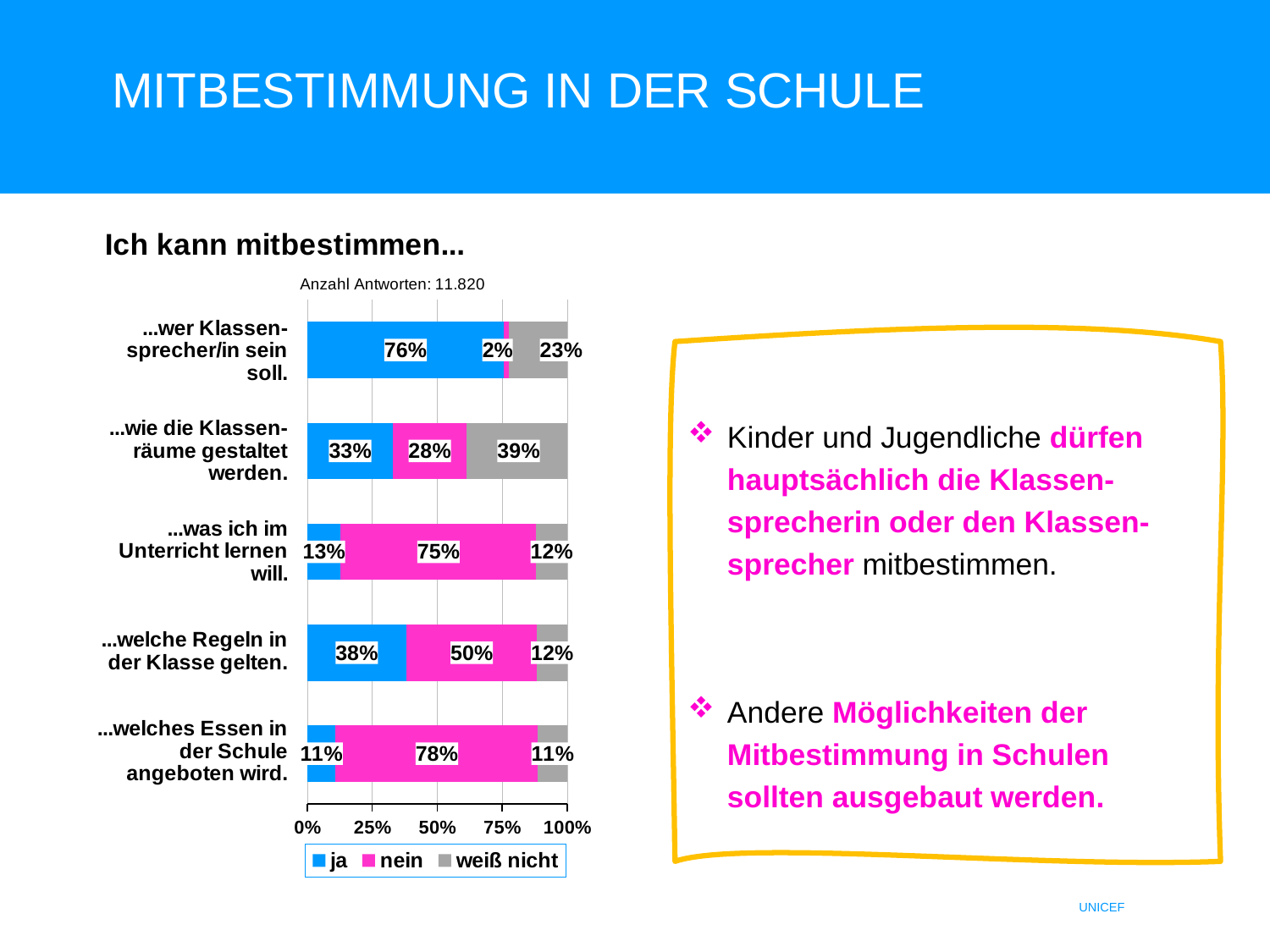
What percentage answered "weiß nicht" for "...wie die Klassenräume gestaltet werden."? 39% Which colour represents "nein" in the chart? Pink (magenta) How many categories (statements) are shown in the chart? 5 How many series does the legend list? 3 What kind of chart is shown on the slide? Stacked bar chart Which category has the highest "ja" share? ...wer Klassensprecher/in sein soll. What percentage answered "nein" for "...welches Essen in der Schule angeboten wird."? 78% Which is larger: the "nein" share for "...was ich im Unterricht lernen will." or the "nein" share for "...wie die Klassenräume gestaltet werden."? ...was ich im Unterricht lernen will. What percentage answered "ja" for "...wer Klassensprecher/in sein soll."? 76% What is the number of responses (Anzahl Antworten) stated above the chart? 11.820 Which category has the lowest "ja" share? ...welches Essen in der Schule angeboten wird. What is the difference between the "nein" share for "...welche Regeln in der Klasse gelten." and the "ja" share for the same category? 12%